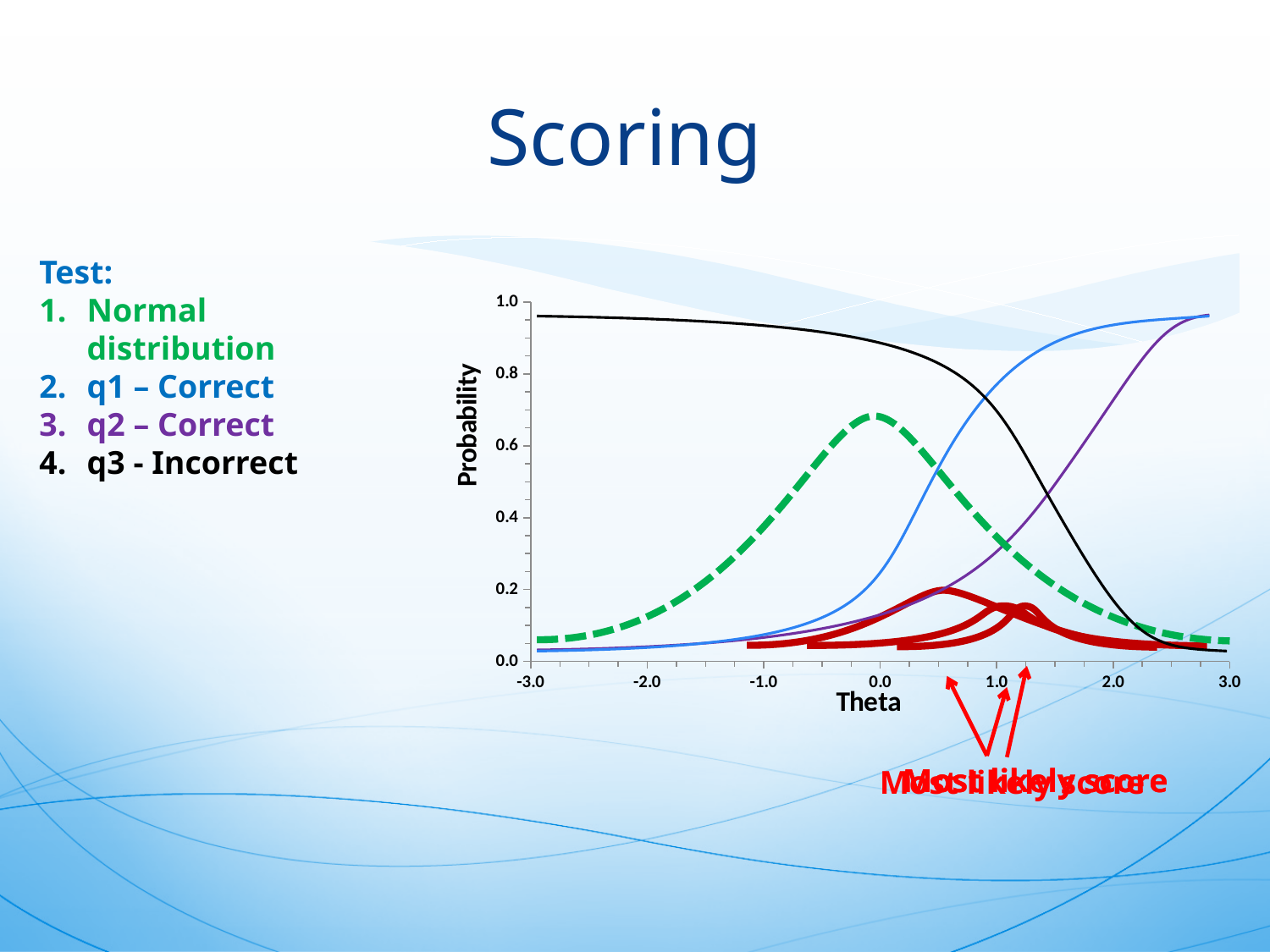
Is the peak of the green dashed normal distribution curve greater or less than 0.6? greater Does the black curve (q3 - Incorrect) rise or fall as Theta increases? fall What is the label of the y axis of the chart? Probability How many tick marks are labelled on the Theta axis? 7 Is the value of the black curve at Theta = -3.0 greater or less than 0.8? greater Is the peak of the green dashed normal distribution curve greater or less than 0.8? less What kind of chart is shown on the slide? line chart What is the label of the x axis of the chart? Theta At Theta = 0.0, which is larger: the black curve or the blue curve? the black curve Does the purple curve (q2 - Correct) rise or fall as Theta increases? rise Does the blue curve (q1 - Correct) rise or fall as Theta increases? rise